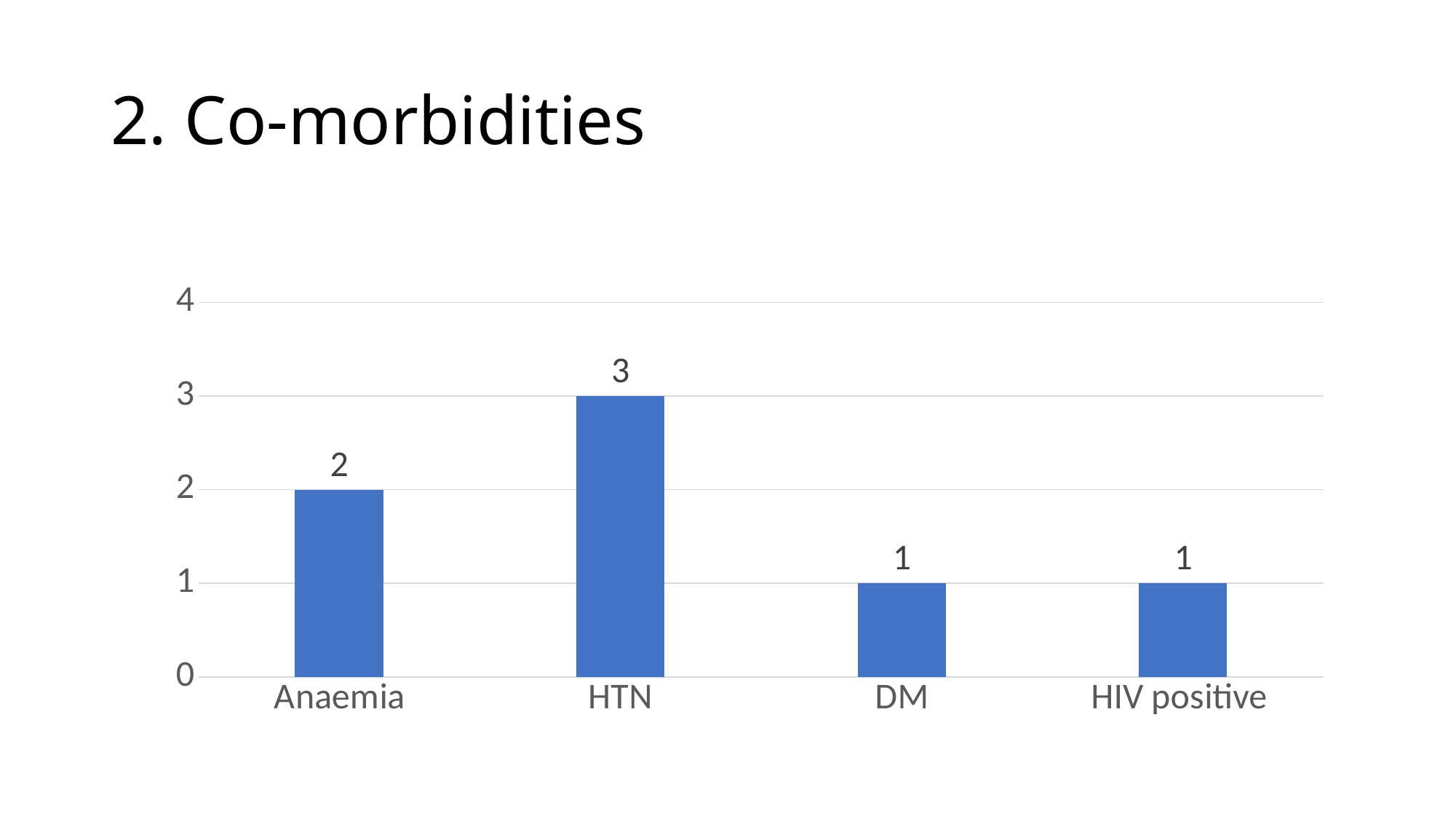
What is the value for Anaemia? 2 What is the title of the slide? 2. Co-morbidities What is the value for DM? 1 Is the value for HTN greater or less than 2? greater What kind of chart is shown on the slide? Bar chart How many categories are shown on the x axis? 4 Which co-morbidity has the highest value? HTN What is the difference between the values for HTN and Anaemia? 1 Which is larger, the value for Anaemia or the value for DM? Anaemia What is the value for HIV positive? 1 What is the value for HTN? 3 What is the difference between the values for HTN and DM? 2